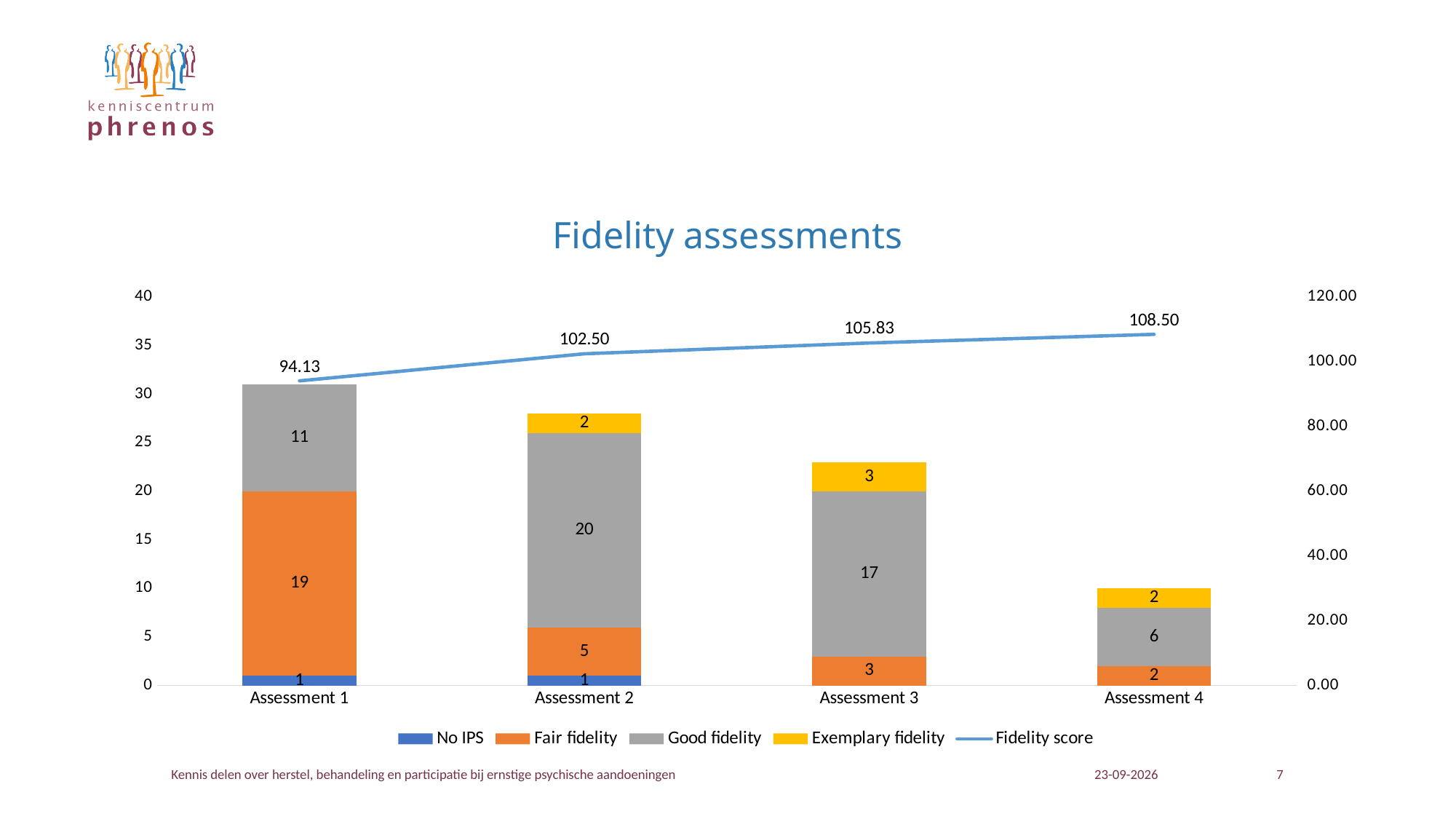
What is the Fair fidelity value for Assessment 1? 19 Which is larger, the Good fidelity value for Assessment 3 or for Assessment 4? Assessment 3 Which assessment has the lowest Fair fidelity value? Assessment 4 Which assessment has the highest Fidelity score? Assessment 4 What is the Fidelity score for Assessment 4? 108.50 What is the Good fidelity value for Assessment 2? 20 Does the Fidelity score rise or fall from Assessment 1 to Assessment 4? rise What is the difference between the Fidelity score for Assessment 2 and Assessment 1? 8.37 What is the Exemplary fidelity value for Assessment 3? 3 What is the total of the stacked bar for Assessment 2? 28 How many series does the legend list? 5 How many assessments are shown on the x axis? 4